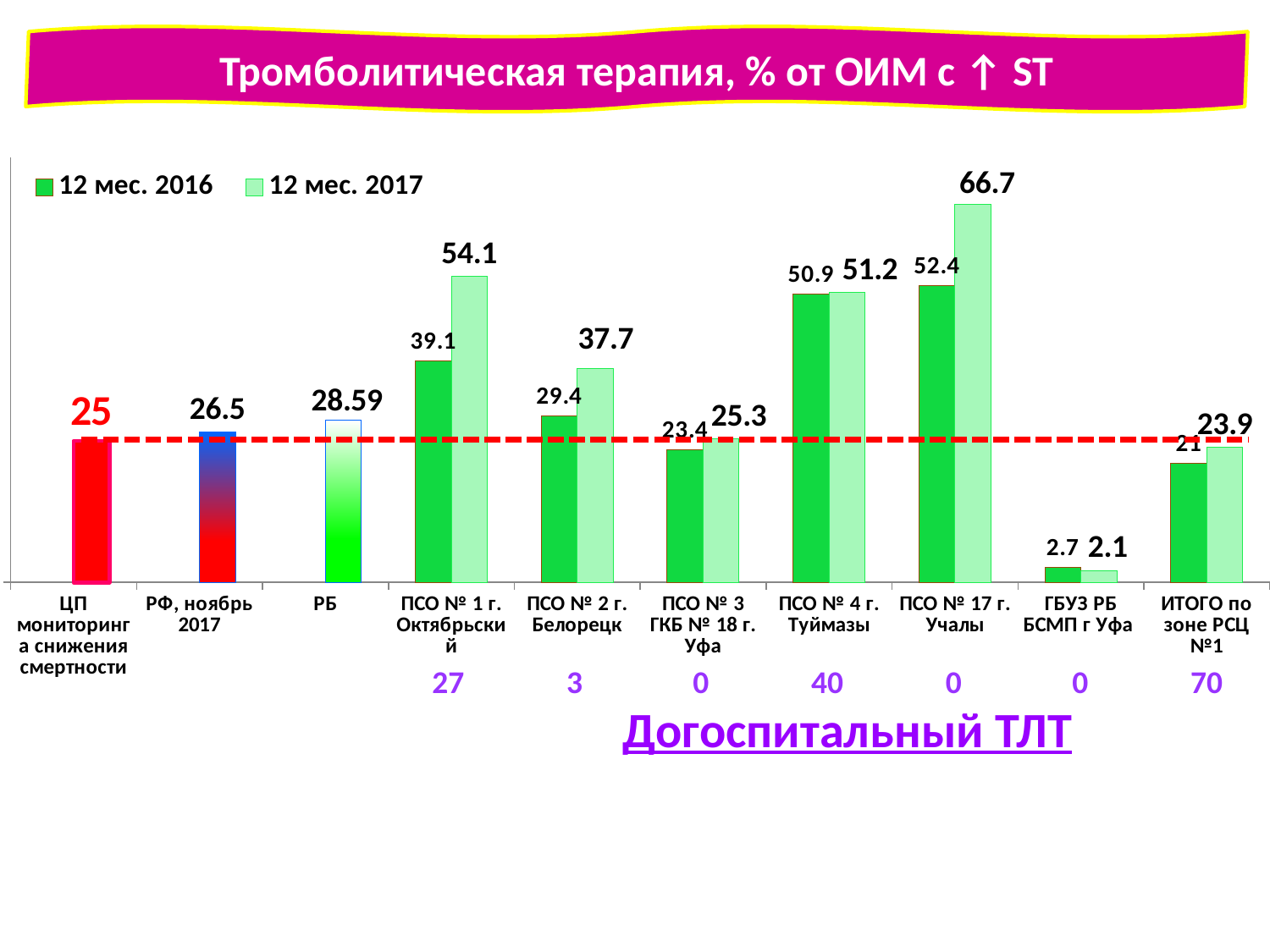
What is the value shown for РБ? 28.59 What is the value for ПСО № 17 г. Учалы in the 12 мес. 2017 series? 66.7 Which category has the highest value in the 12 мес. 2017 series? ПСО № 17 г. Учалы How many series does the legend list? 2 Which is larger for ГБУЗ РБ БСМП г Уфа: the 12 мес. 2016 value or the 12 мес. 2017 value? 12 мес. 2016 How many categories are shown on the x axis? 10 Which category has the lowest value in the 12 мес. 2016 series? ГБУЗ РБ БСМП г Уфа What is the value for ИТОГО по зоне РСЦ №1 in the 12 мес. 2017 series? 23.9 What kind of chart is shown on the slide? bar chart What value is shown for ЦП мониторинга снижения смертности, marked by the red dashed line? 25 What is the difference between the 12 мес. 2017 and 12 мес. 2016 values for ПСО № 1 г. Октябрьский? 15 What is the value for ПСО № 1 г. Октябрьский in the 12 мес. 2016 series? 39.1